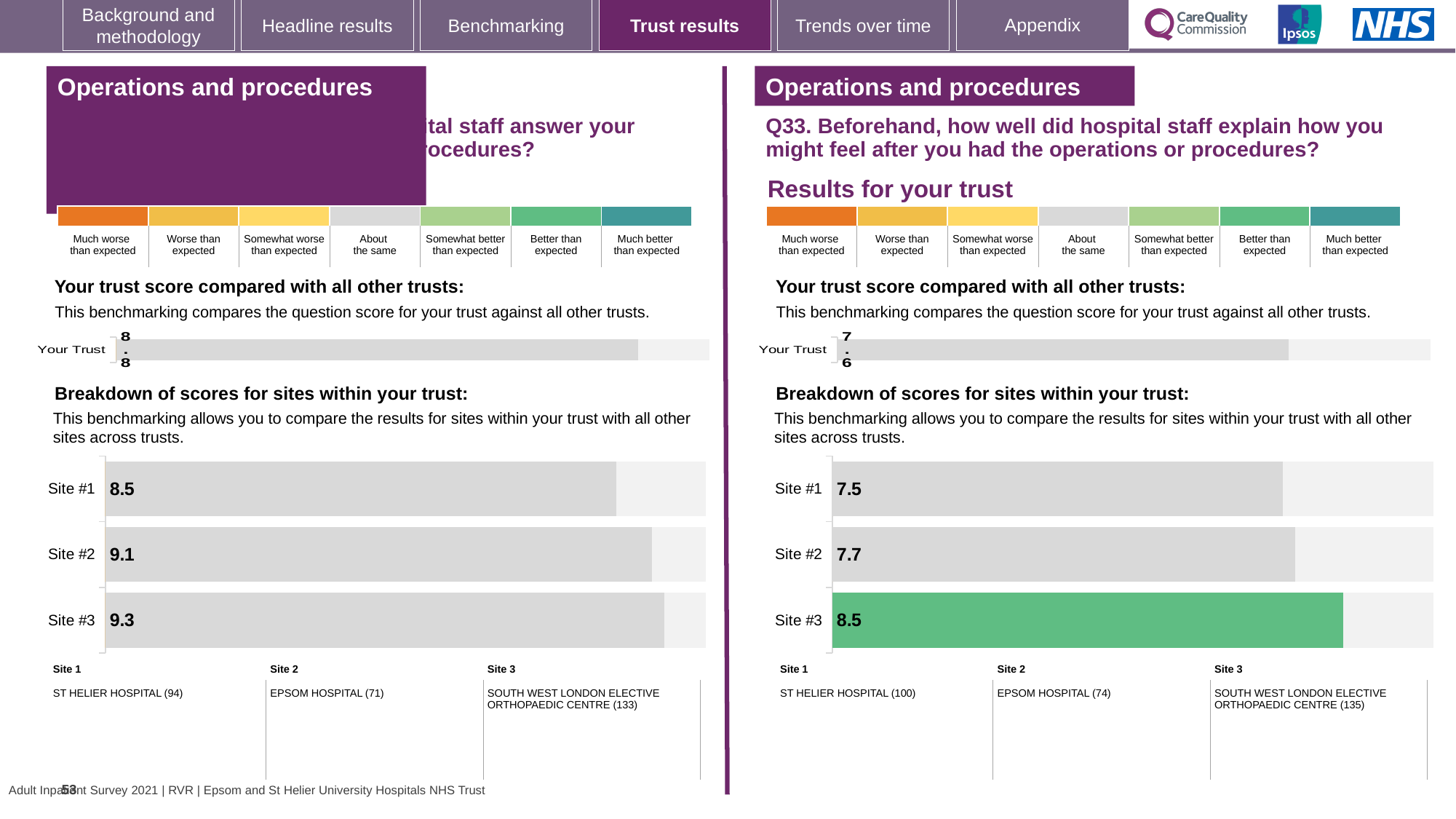
On the right panel (Q33) 'Your trust score compared with all other trusts' chart, what is the value for Your Trust? 7.6 On the right panel (Q33) site breakdown chart, which site has the lowest score? Site #1 On the right panel (Q33) site breakdown chart, which is larger: the score for Site #2 or Site #3? Site #3 On the right panel (Q33) site breakdown chart, which site's bar is coloured green rather than grey? Site #3 On the left panel's site breakdown chart, what is the difference between the scores for Site #3 and Site #1? 0.8 On the right panel (Q33) 'Breakdown of scores for sites within your trust' chart, what is the value for Site #1? 7.5 On the right panel (Q33) site breakdown chart, what is the difference between the scores for Site #3 and Site #2? 0.8 On the left panel's site breakdown chart, which site has the highest score? Site #3 On the left panel's 'Breakdown of scores for sites within your trust' chart, what is the value for Site #2? 9.1 On the left panel's 'Your trust score compared with all other trusts' chart, what is the value for Your Trust? 8.8 What kind of chart is the site breakdown chart on the right panel (Q33)? Bar chart How many sites are shown on the left panel's site breakdown chart? 3